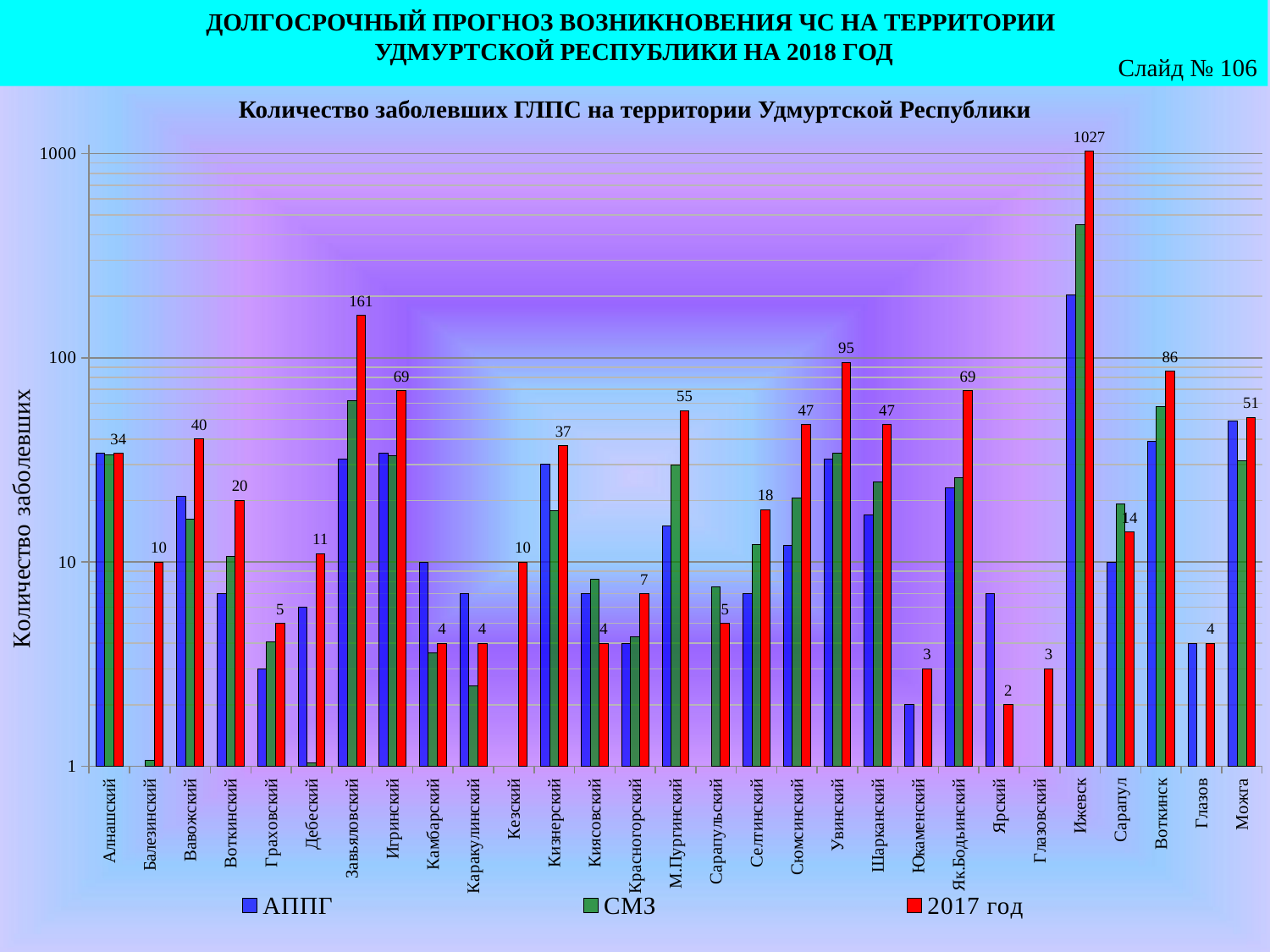
In the 2017 год series, which is larger: Завьяловский or Увинский? Завьяловский Which category has the highest value in the 2017 год series? Ижевск Is the АППГ value for Ижевск greater or less than 100? greater How many categories are shown on the x axis? 29 What is the difference between the 2017 год values for Увинский and Воткинск? 9 Which category has the lowest value in the 2017 год series? Ярский What is the value for Завьяловский in the 2017 год series? 161 Is the СМЗ value for Завьяловский greater or less than 100? less How many series does the legend list? 3 What is the value for Можга in the 2017 год series? 51 What kind of chart is shown on the slide? Bar chart What is the value for Ижевск in the 2017 год series? 1027